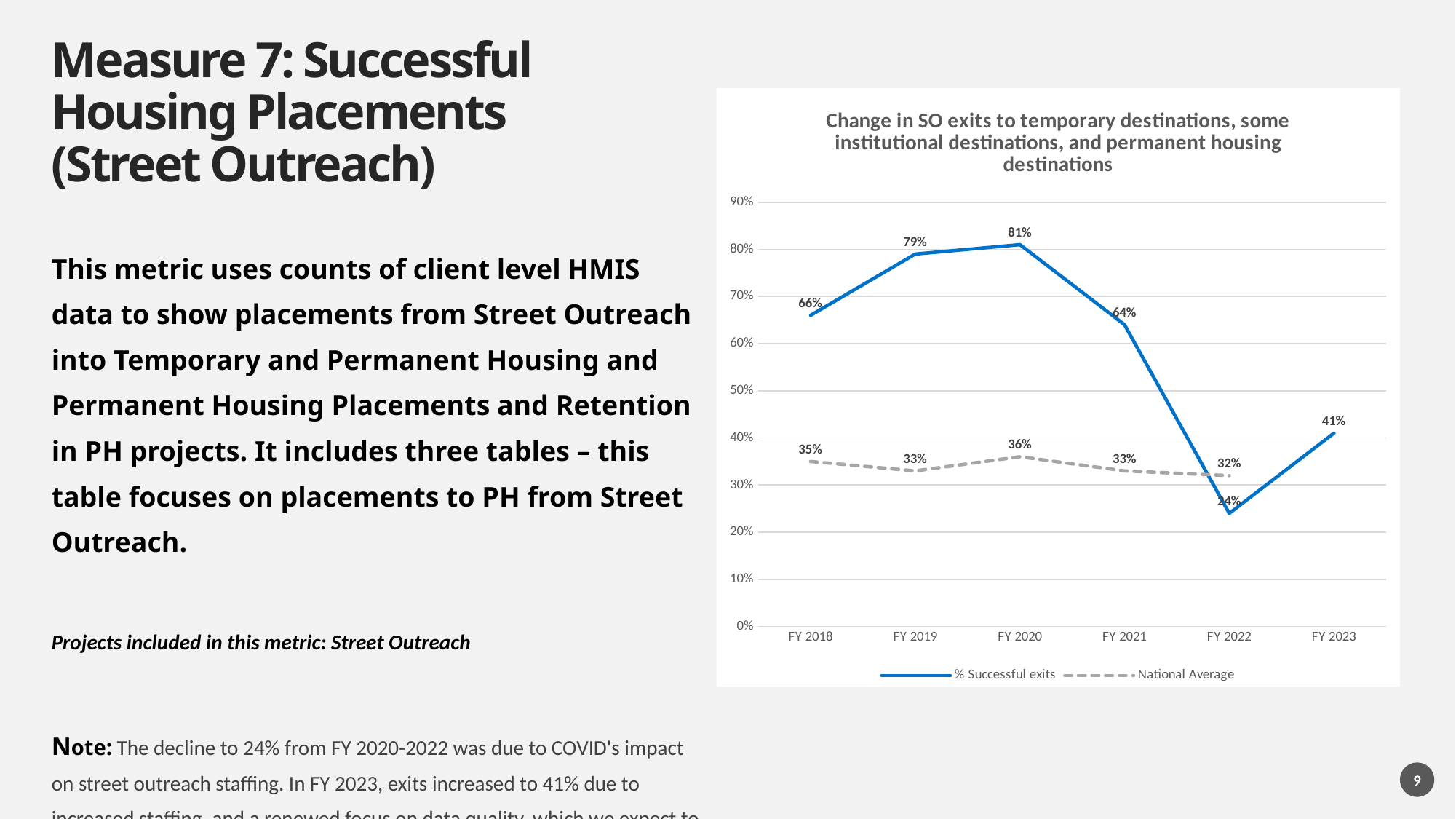
How many fiscal years are shown on the x axis? 6 What is the difference between the % Successful exits values for FY 2020 and FY 2022? 57% Which is larger in FY 2021: the % Successful exits value or the National Average value? % Successful exits In which fiscal year is the % Successful exits value lowest? FY 2022 What type of chart is shown on the slide? Line chart Does the % Successful exits line rise or fall from FY 2022 to FY 2023? Rise In which fiscal year is the % Successful exits value highest? FY 2020 What is the National Average value for FY 2018? 35% How many series does the legend list? 2 What is the % Successful exits value for FY 2020? 81% What is the % Successful exits value for FY 2022? 24% Which series is drawn with a dashed grey line? National Average